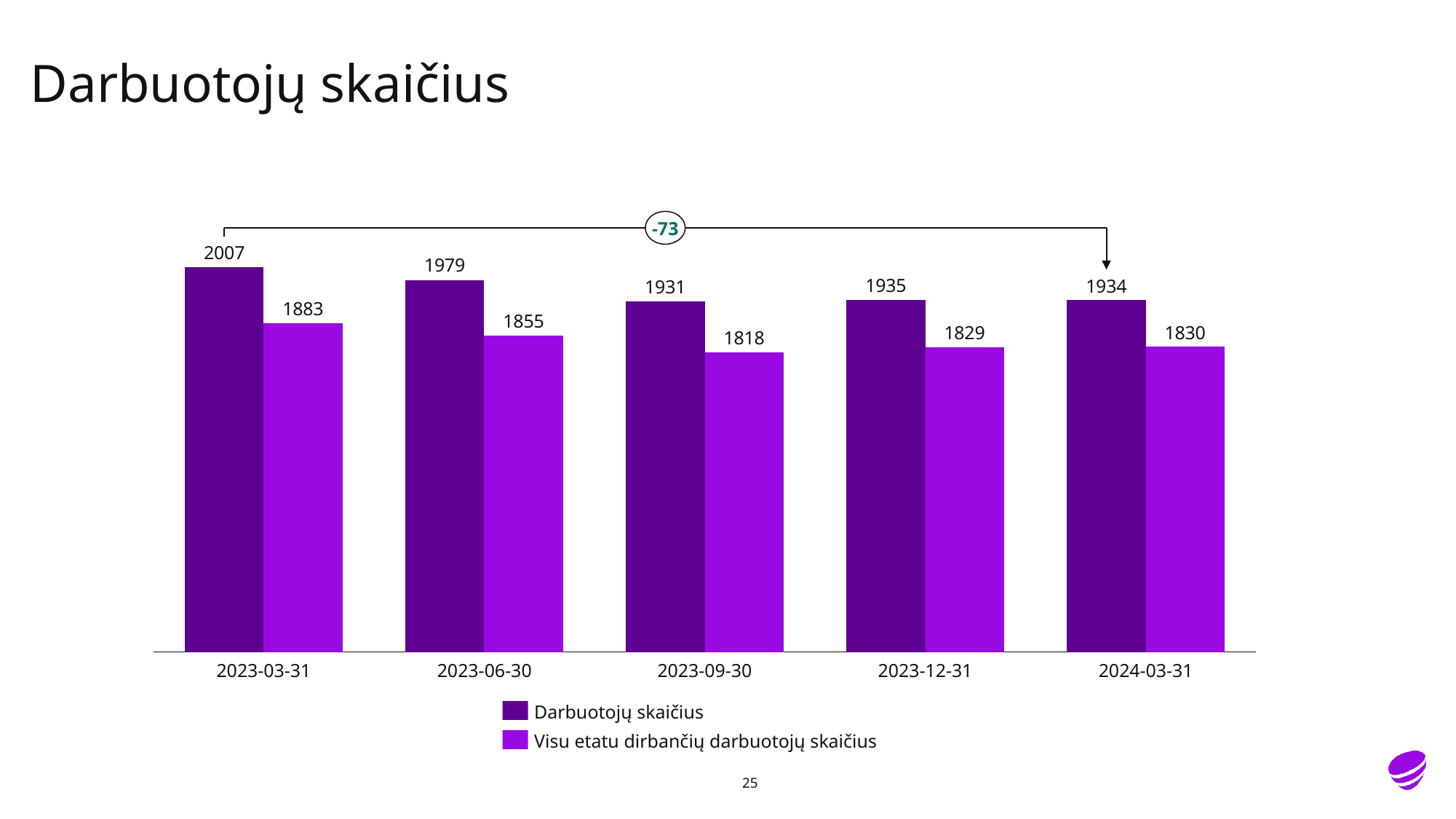
Which date has the highest value for Darbuotojų skaičius? 2023-03-31 How many dates are shown on the x axis? 5 What is the title of the slide? Darbuotojų skaičius How many series does the legend list? 2 What is the difference between Darbuotojų skaičius and Visu etatu dirbančių darbuotojų skaičius on 2023-12-31? 106 What is the value of Darbuotojų skaičius for 2024-03-31? 1934 Which date has the lowest value for Visu etatu dirbančių darbuotojų skaičius? 2023-09-30 What kind of chart is shown on the slide? Bar chart What is the difference between Darbuotojų skaičius on 2023-03-31 and on 2024-03-31? 73 What is the value of Darbuotojų skaičius for 2023-03-31? 2007 Which is larger: Darbuotojų skaičius on 2023-06-30 or on 2023-09-30? 2023-06-30 What is the value of Visu etatu dirbančių darbuotojų skaičius for 2023-09-30? 1818